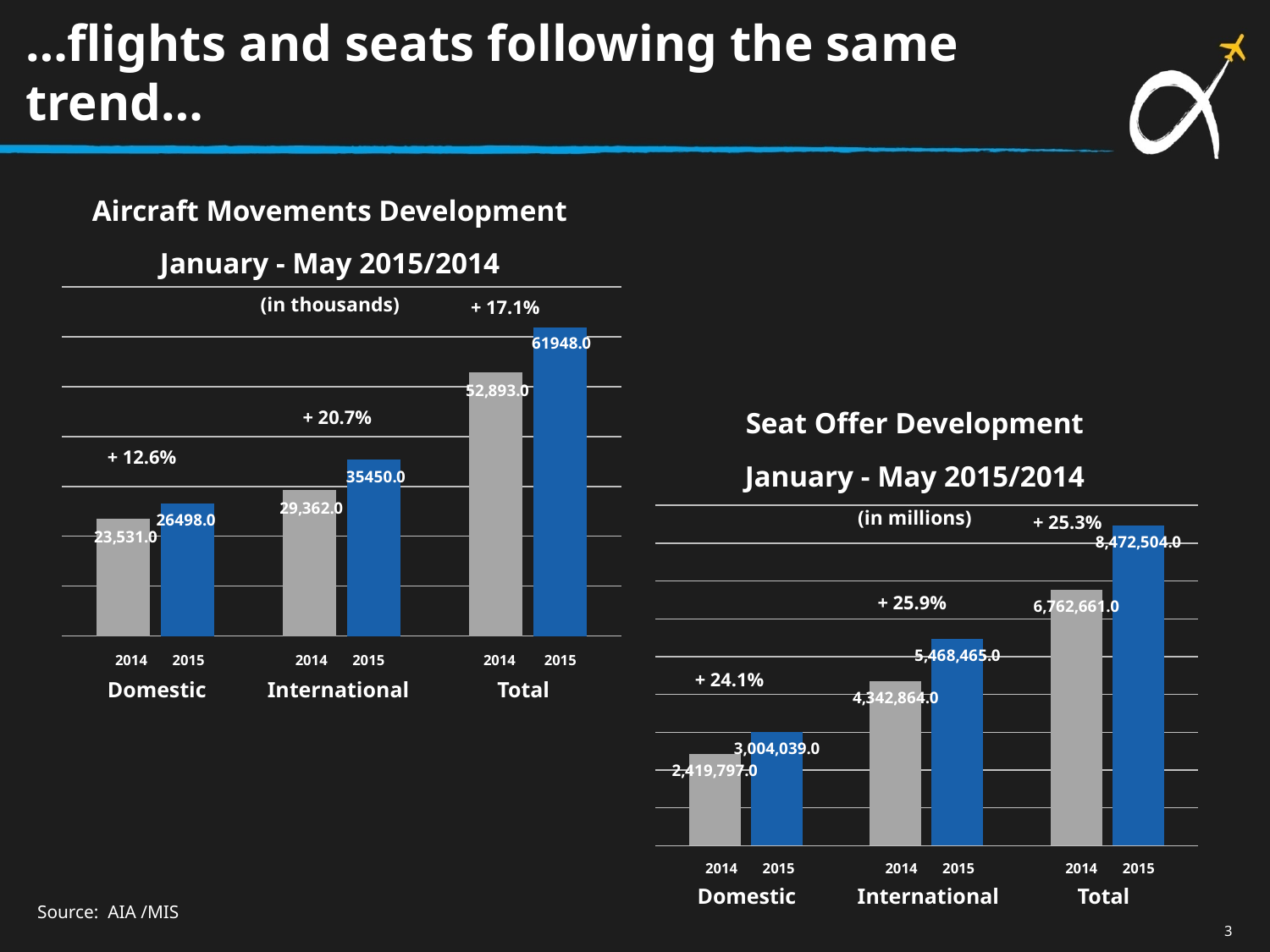
In the Aircraft Movements Development chart, what is the difference between the Total values for 2015 and 2014? 9,055.0 In the Seat Offer Development chart, which is larger: International 2015 or Total 2014? Total 2014 In the Seat Offer Development chart, what is the value for Domestic in 2015? 3,004,039.0 In the Seat Offer Development chart, what percentage change is shown above the Domestic bars? + 24.1% In the Seat Offer Development chart, what is the value for Total in 2015? 8,472,504.0 In the Aircraft Movements Development chart, what percentage change is shown above the International bars? + 20.7% In the Aircraft Movements Development chart, what is the value for International in 2015? 35450.0 In the Aircraft Movements Development chart, which category has the lowest 2014 value? Domestic In the Seat Offer Development chart, what is the value for International in 2014? 4,342,864.0 What kind of chart is the Seat Offer Development chart? Bar chart In the Aircraft Movements Development chart, what is the value for Domestic in 2014? 23,531.0 In the Aircraft Movements Development chart, what is the value for Total in 2015? 61948.0